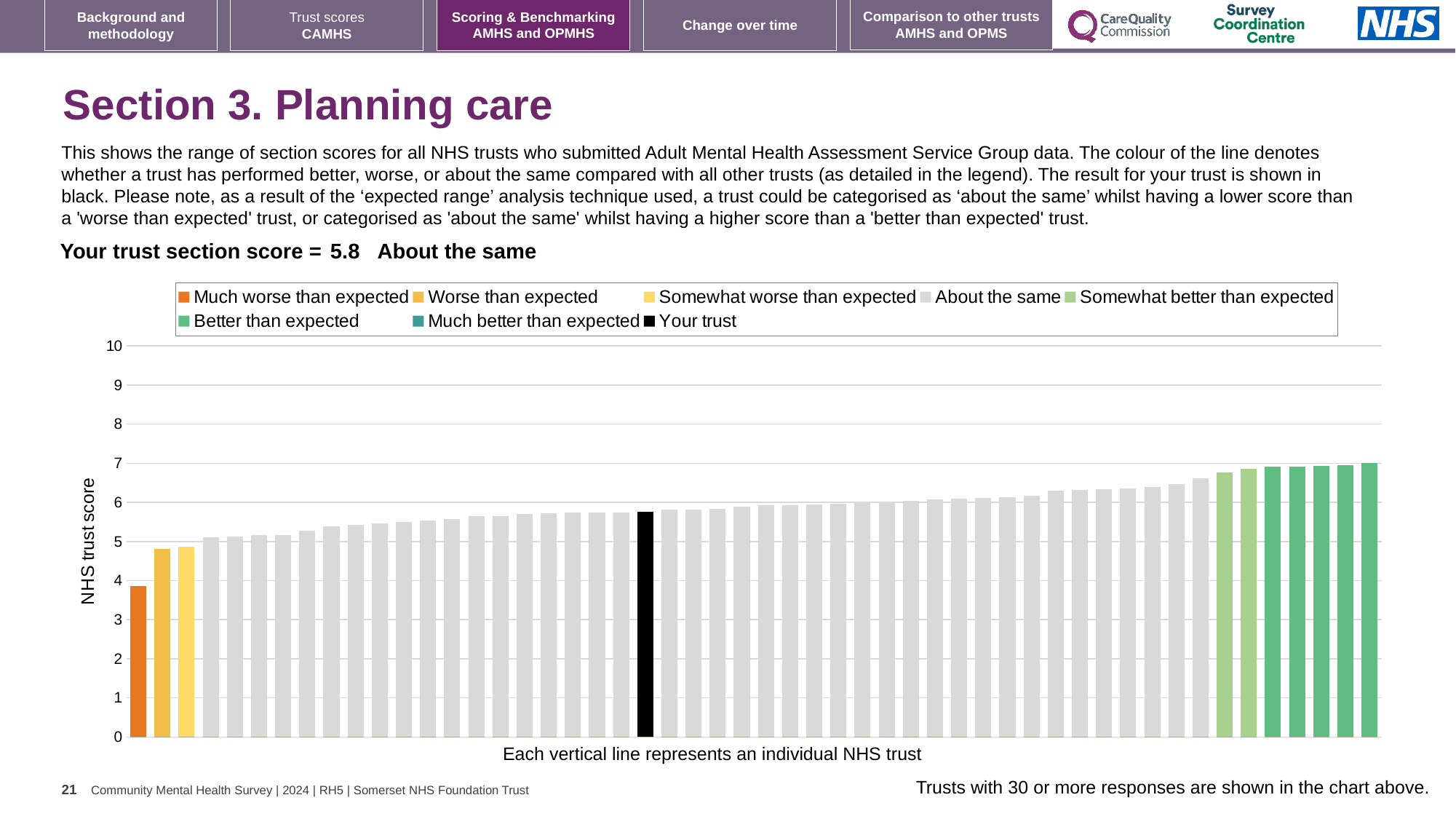
How many bars are coloured as 'Worse than expected' (yellow-orange)? 1 Which legend category does the lowest bar in the chart belong to? Much worse than expected Is the value of the lowest bar (the orange 'Much worse than expected' bar) greater or less than 5? less Do the bar values rise or fall from left to right along the x axis? rise Is the value of the black 'Your trust' bar greater or less than 6? less How many entries does the chart legend list? 8 What is the section score for your trust shown on the slide? 5.8 Which is larger: the black 'Your trust' bar or the orange 'Much worse than expected' bar? Your trust Is the value of the black 'Your trust' bar greater or less than 5? greater What kind of chart is shown on the slide? bar chart What is the label on the vertical axis of the chart? NHS trust score